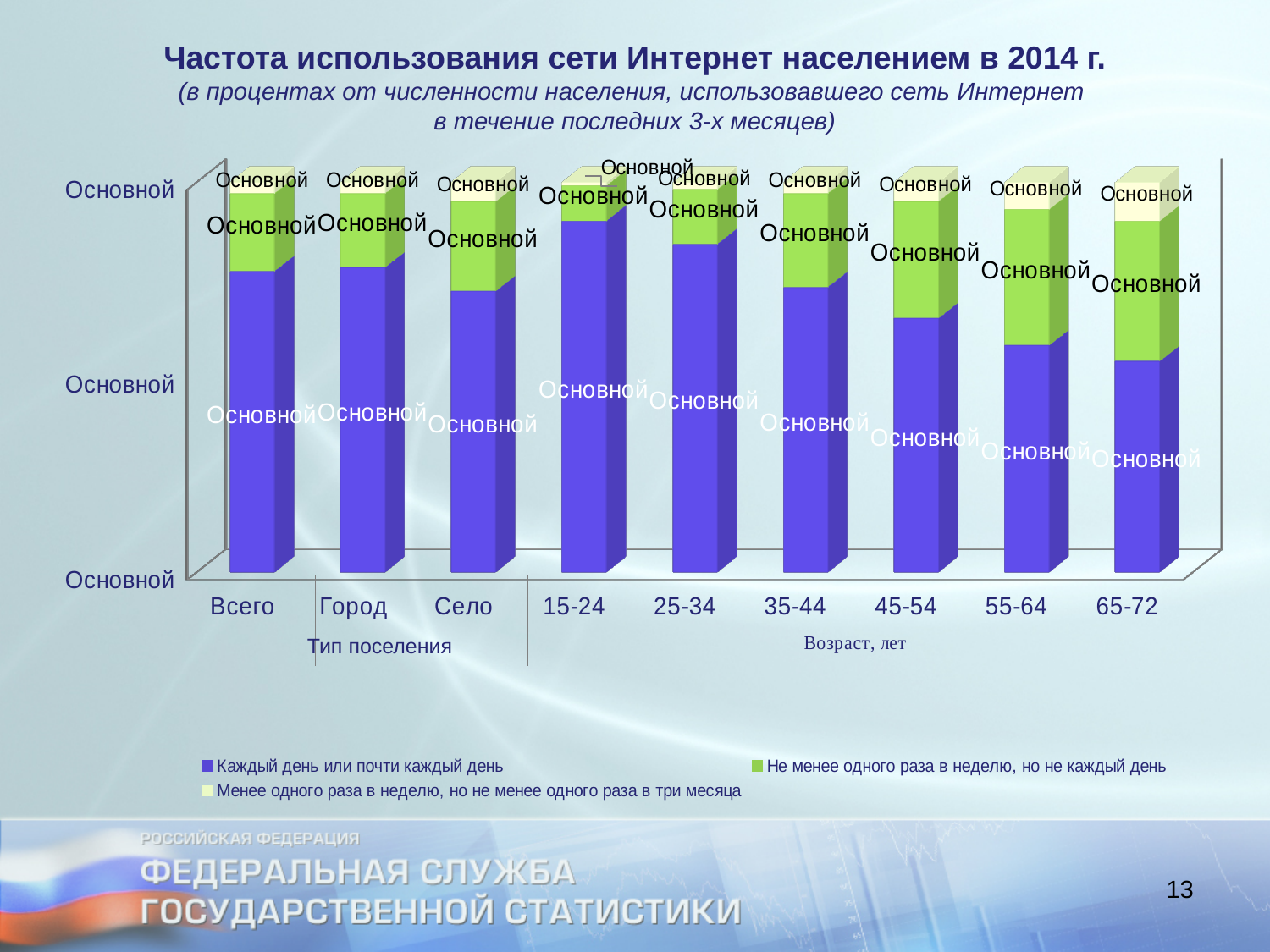
What year does the chart title refer to? 2014 How many categories are shown along the x axis of the chart? 9 Which category has the shortest blue segment (Каждый день или почти каждый день)? 65-72 Which has the larger blue segment (Каждый день или почти каждый день): Город or Село? Город How many series does the chart's legend list? 3 Which age group has the largest light-yellow segment (Менее одного раза в неделю, но не менее одного раза в три месяца)? 65-72 Across the age groups from 15-24 to 65-72, does the blue segment (Каждый день или почти каждый день) rise or fall? fall What kind of chart is shown on the slide? bar chart Which series is shown in blue according to the legend? Каждый день или почти каждый день Which has the larger blue segment (Каждый день или почти каждый день): 25-34 or 55-64? 25-34 Which category has the tallest blue segment (Каждый день или почти каждый день)? 15-24 Which has the larger green segment (Не менее одного раза в неделю, но не каждый день): 15-24 or 65-72? 65-72